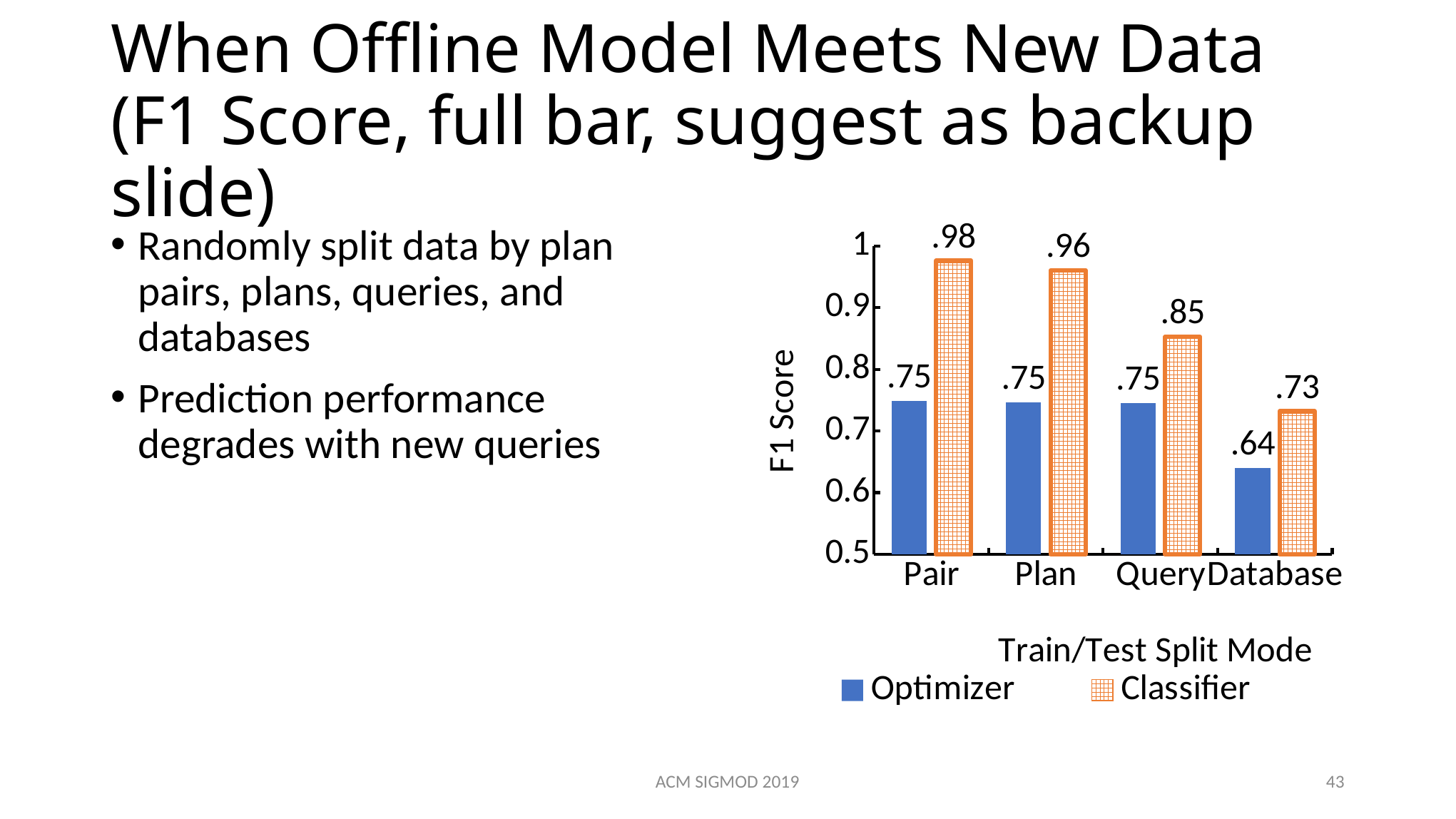
What is the Classifier F1 Score for the Query split mode? .85 What is the Classifier F1 Score for the Pair split mode? .98 How many split modes are shown on the x axis? 4 What is the difference between the Classifier and Optimizer F1 Scores for the Plan split mode? .21 How many series does the legend list? 2 What kind of chart is shown on the slide? bar chart Which split mode has the highest Classifier F1 Score? Pair Which split mode has the lowest Optimizer F1 Score? Database What is the label of the x axis? Train/Test Split Mode Is the Classifier F1 Score for the Database split mode greater or less than 0.8? less Which is larger for the Database split mode, the Optimizer or the Classifier F1 Score? Classifier What is the Optimizer F1 Score for the Database split mode? .64